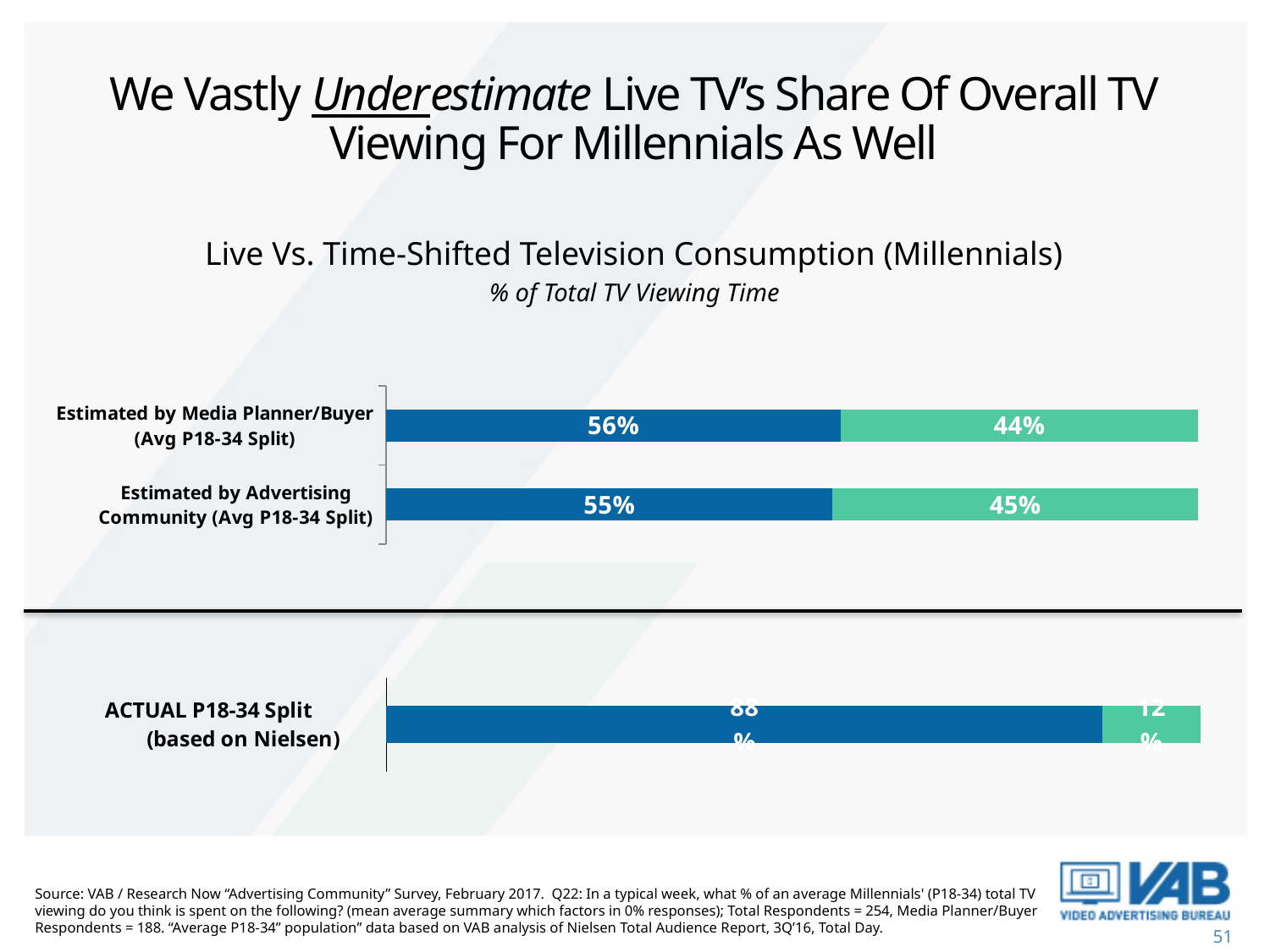
In the bottom chart, what is the value of the blue segment for 'ACTUAL P18-34 Split (based on Nielsen)'? 88% In the top chart, what is the value of the green segment for 'Estimated by Advertising Community (Avg P18-34 Split)'? 45% What is the title of the chart on this slide? Live Vs. Time-Shifted Television Consumption (Millennials) What type of chart is used on this slide? Bar chart In the top chart, what is the difference between the blue segment values for 'Estimated by Media Planner/Buyer' and 'Estimated by Advertising Community'? 1% In the bottom chart, what is the value of the green segment for 'ACTUAL P18-34 Split (based on Nielsen)'? 12% In the top chart, what is the value of the blue segment for 'Estimated by Media Planner/Buyer (Avg P18-34 Split)'? 56% In the top chart, which bar has the larger green segment: 'Estimated by Media Planner/Buyer' or 'Estimated by Advertising Community'? Estimated by Advertising Community How many bars are shown in the top chart? 2 In the top chart, what is the total of the two segments for 'Estimated by Advertising Community (Avg P18-34 Split)'? 100% What is the difference between the blue segment in the bottom chart (ACTUAL P18-34 Split) and the blue segment for 'Estimated by Media Planner/Buyer' in the top chart? 32% In the top chart, what is the value of the green segment for 'Estimated by Media Planner/Buyer (Avg P18-34 Split)'? 44%